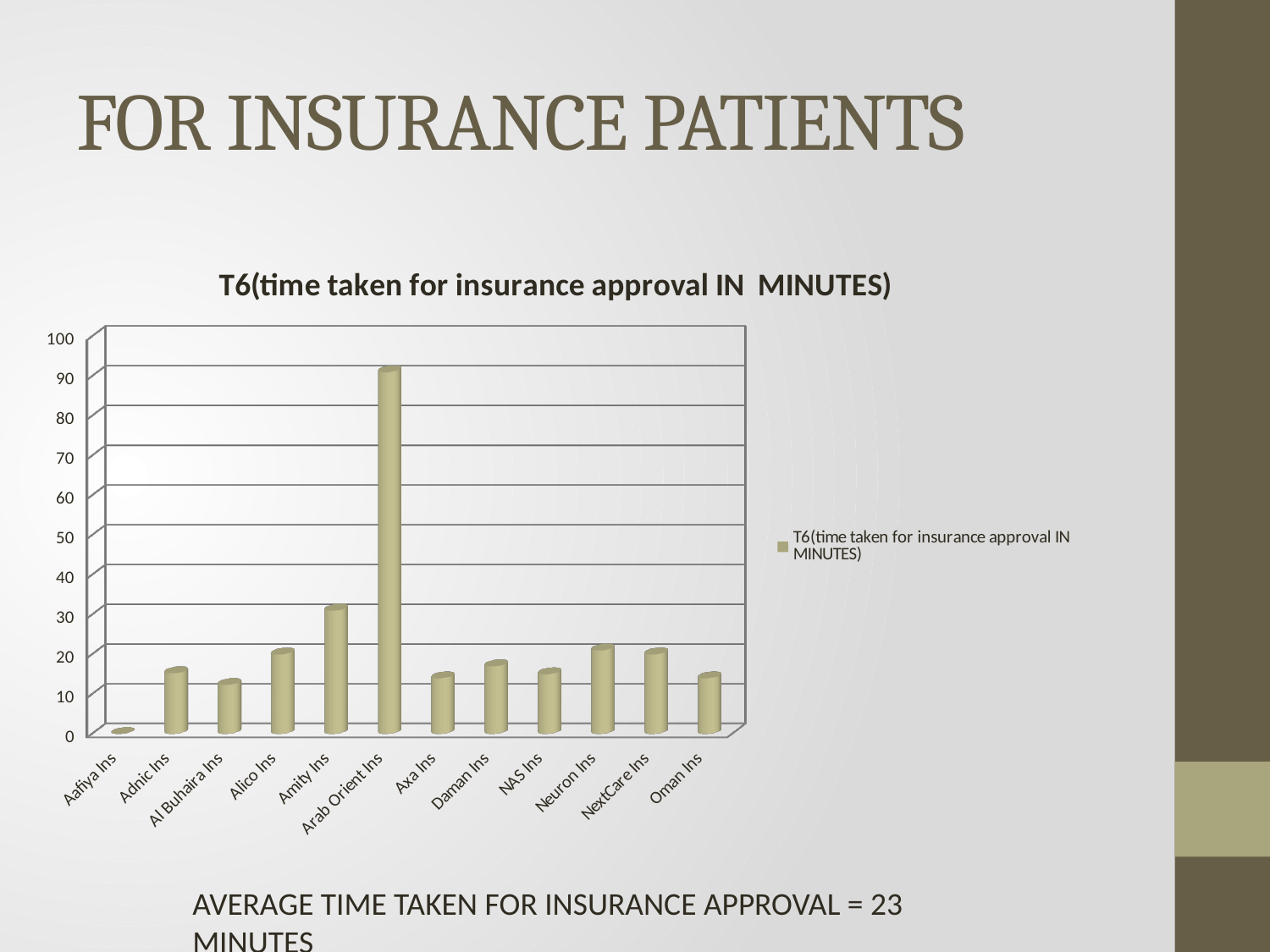
Which insurance company has the highest time taken for insurance approval? Arab Orient Ins Which has a larger value, Al Buhaira Ins or Alico Ins? Alico Ins What kind of chart is shown on the slide? Bar chart Which insurance company has the lowest time taken for insurance approval? Aafiya Ins How many insurance companies are shown on the x axis of the chart? 12 Is the value for Al Buhaira Ins greater or less than 20? less Is the value for Arab Orient Ins greater or less than 80? greater Which has a larger value, Amity Ins or Adnic Ins? Amity Ins Is the value for Aafiya Ins greater or less than 10? less How many series does the chart legend list? 1 What is the title of the chart? T6(time taken for insurance approval IN MINUTES)